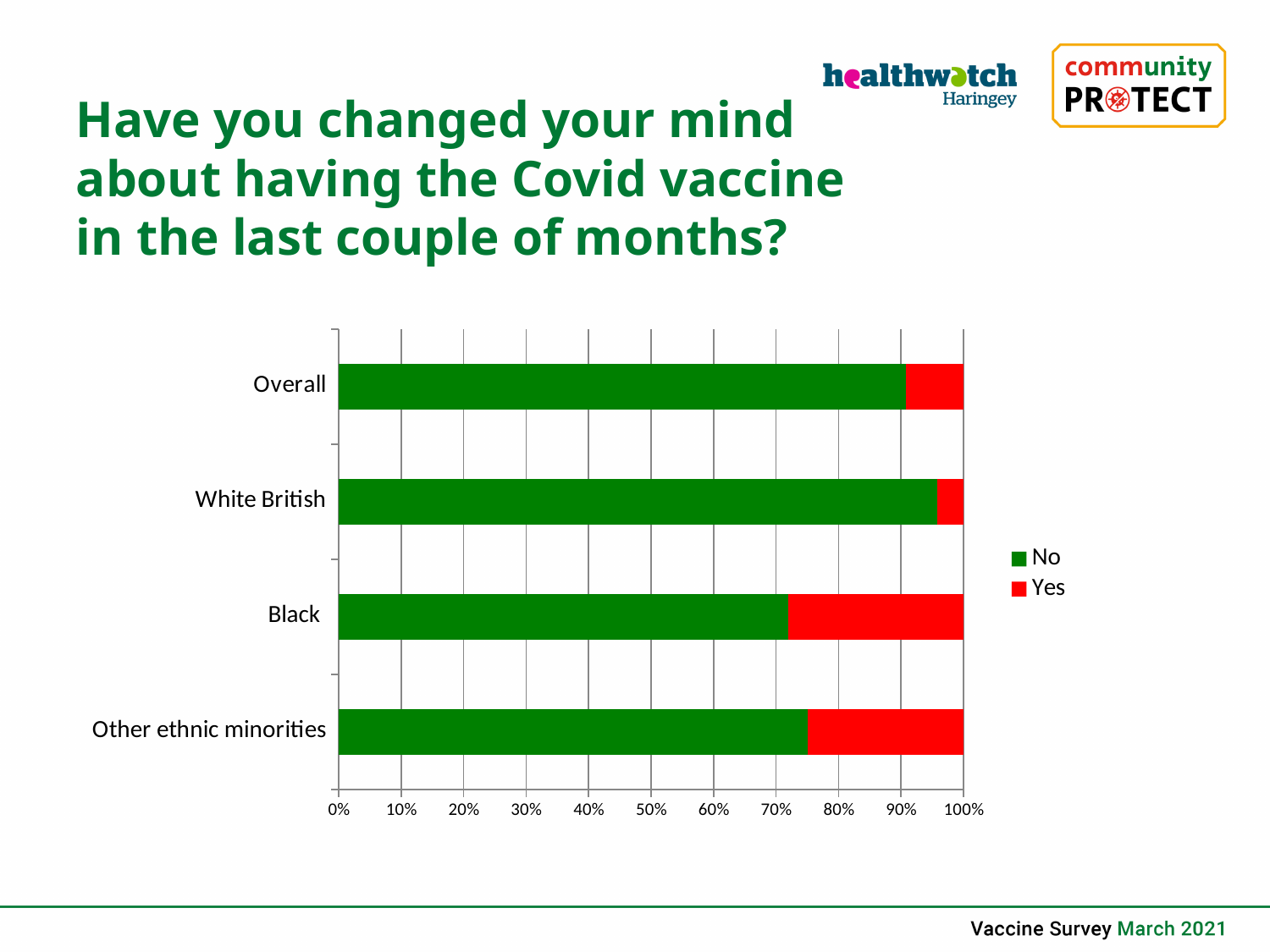
Is the 'No' share for White British greater or less than 90%? greater Which has a larger 'Yes' share, Black or Overall? Black How many categories are shown on the chart? 4 What kind of chart is shown on the slide? stacked bar chart Is the 'No' share for Other ethnic minorities greater or less than 80%? less Which has a larger 'No' share, White British or Black? White British Which category has the highest share of 'No' responses? White British Is the 'No' share for Overall greater or less than 80%? greater How many series does the legend list? 2 What colour represents the 'Yes' series in the chart? red Which category has the lowest share of 'Yes' responses? White British